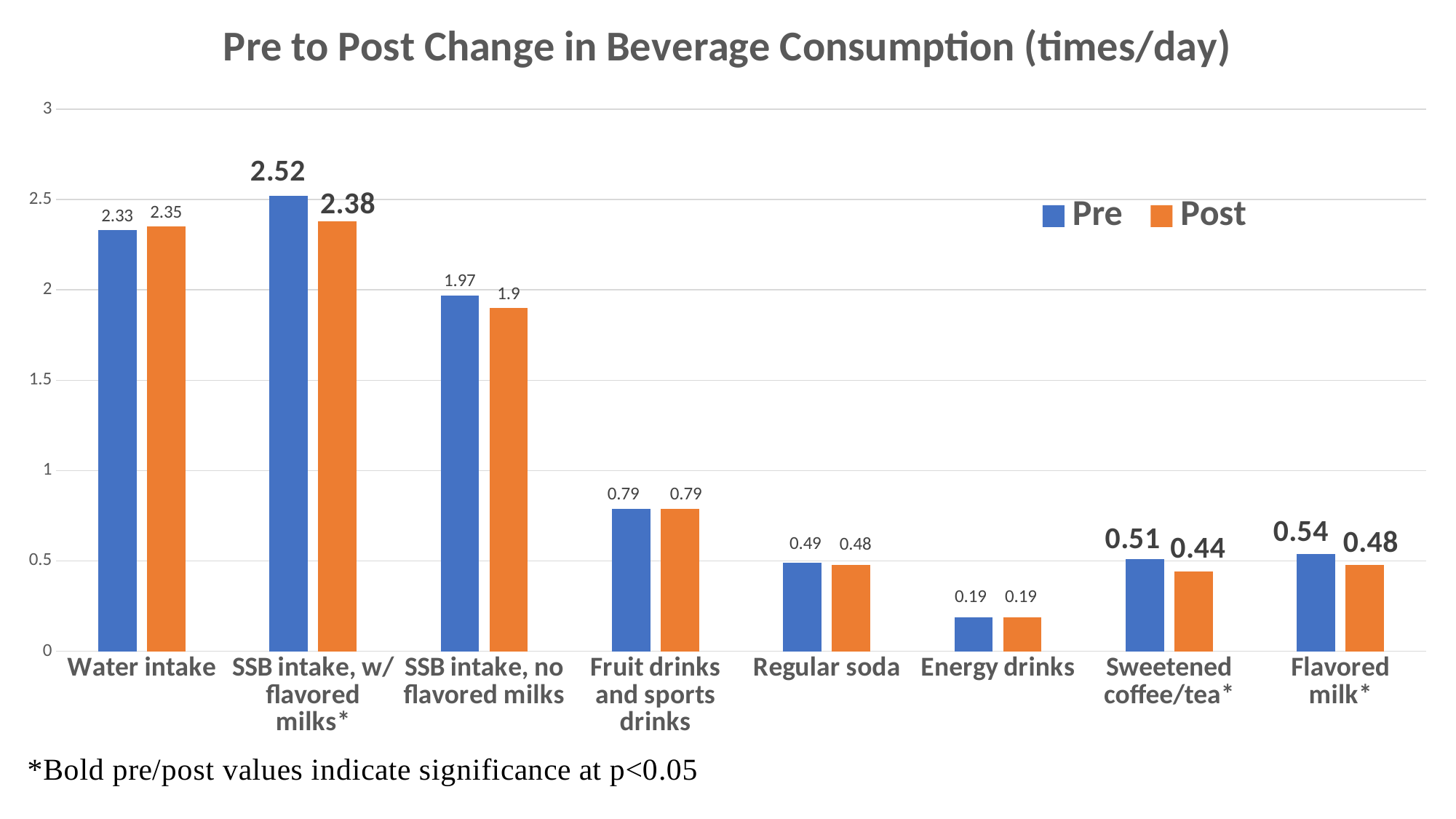
What kind of chart is shown on the slide? Bar chart What is the Post value for SSB intake, no flavored milks? 1.9 What is the difference between the Pre and Post values for Sweetened coffee/tea*? 0.07 How many series does the legend list? 2 Which category has the highest Pre value? SSB intake, w/ flavored milks* Which category has the lowest Post value? Energy drinks What is the Pre value for Water intake? 2.33 What is the Pre value for Flavored milk*? 0.54 Which is larger for SSB intake, no flavored milks: the Pre value or the Post value? Pre What is the difference between the Pre and Post values for SSB intake, w/ flavored milks*? 0.14 How many beverage categories are shown on the x axis? 8 What is the Post value for SSB intake, w/ flavored milks*? 2.38